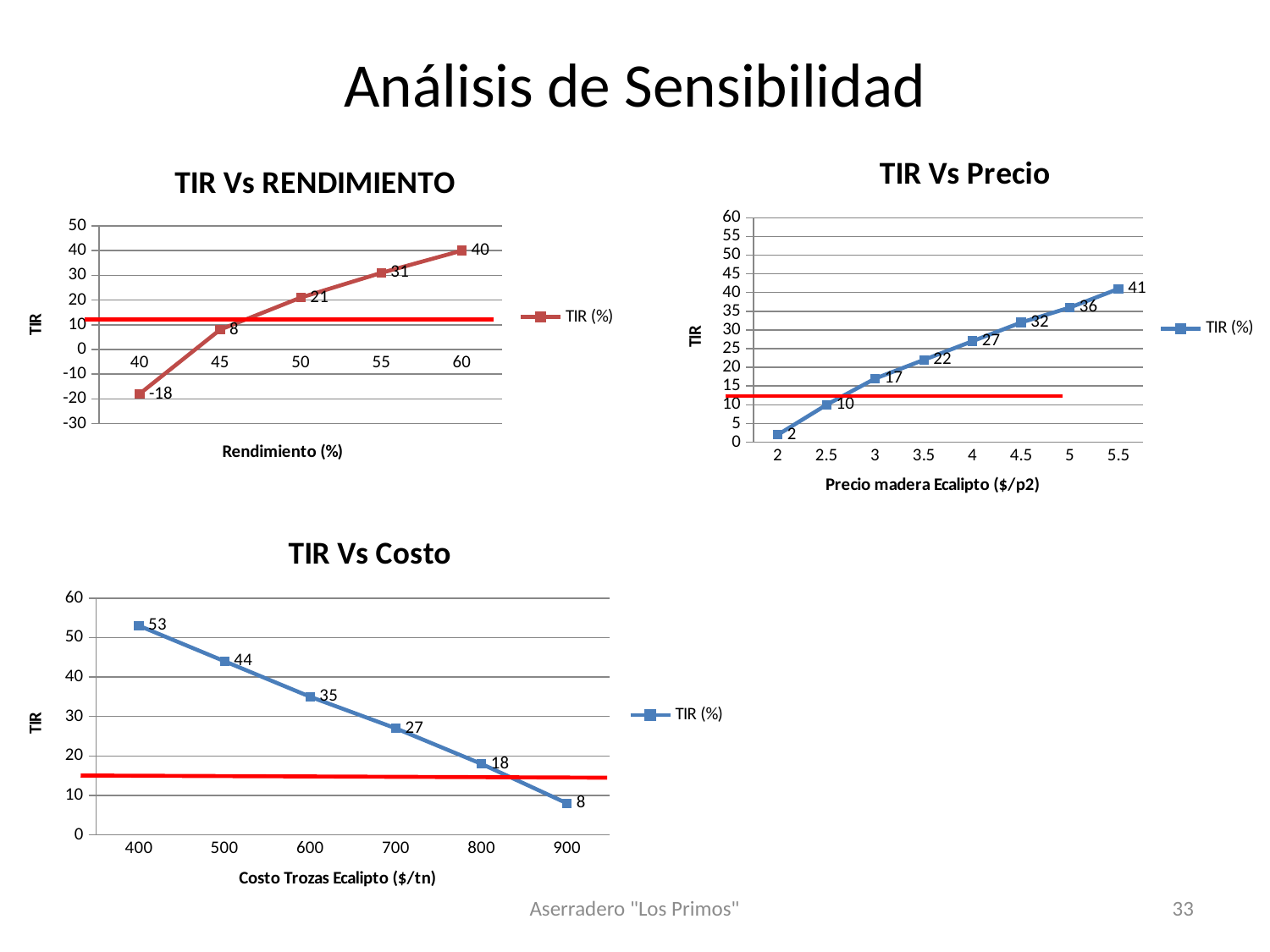
What kind of chart is the 'TIR Vs Costo' chart? line chart In the 'TIR Vs Costo' chart, what is the difference between the TIR (%) at cost 400 and at cost 900? 45 In the 'TIR Vs RENDIMIENTO' chart, what is the difference between the TIR (%) at Rendimiento 60 and at Rendimiento 50? 19 In the 'TIR Vs Precio' chart, how many data points are plotted? 8 In the 'TIR Vs RENDIMIENTO' chart, how many data points are plotted? 5 In the 'TIR Vs Precio' chart, do the TIR (%) values rise or fall as the price increases? rise In the 'TIR Vs Costo' chart, what is the TIR (%) value at a cost of 700? 27 In the 'TIR Vs Precio' chart, what is the TIR (%) value at a price of 3.5? 22 In the 'TIR Vs Costo' chart, do the TIR (%) values rise or fall as the cost increases? fall In the 'TIR Vs Precio' chart, which price has the highest TIR (%)? 5.5 In the 'TIR Vs RENDIMIENTO' chart, what is the TIR (%) value at a Rendimiento of 45? 8 In the 'TIR Vs RENDIMIENTO' chart, which Rendimiento value has the lowest TIR (%)? 40